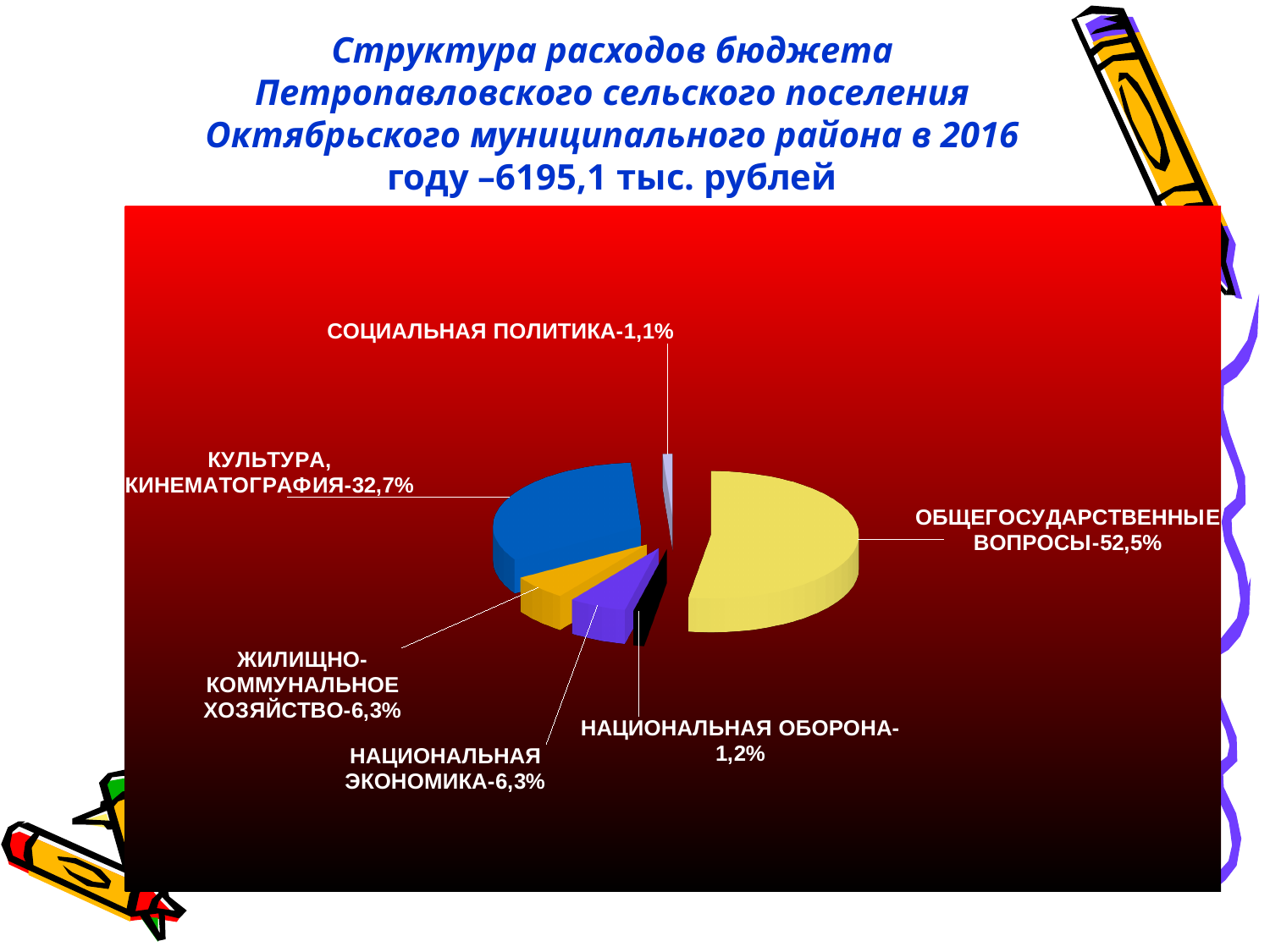
What percentage is shown for НАЦИОНАЛЬНАЯ ОБОРОНА? 1,2% Which category has the largest share of the pie? ОБЩЕГОСУДАРСТВЕННЫЕ ВОПРОСЫ What colour is the slice for ОБЩЕГОСУДАРСТВЕННЫЕ ВОПРОСЫ? yellow How many slices does the pie chart have? 6 What percentage is shown for ЖИЛИЩНО-КОММУНАЛЬНОЕ ХОЗЯЙСТВО? 6,3% What total budget expenditure amount is stated in the slide title? 6195,1 тыс. рублей What percentage is shown for КУЛЬТУРА, КИНЕМАТОГРАФИЯ? 32,7% What kind of chart is shown on the slide? pie chart What share of the budget expenditure goes to ОБЩЕГОСУДАРСТВЕННЫЕ ВОПРОСЫ? 52,5% Which category has the smallest share of the pie? СОЦИАЛЬНАЯ ПОЛИТИКА Which is larger, the share for НАЦИОНАЛЬНАЯ ЭКОНОМИКА or the share for НАЦИОНАЛЬНАЯ ОБОРОНА? НАЦИОНАЛЬНАЯ ЭКОНОМИКА What is the difference in percentage points between ОБЩЕГОСУДАРСТВЕННЫЕ ВОПРОСЫ and КУЛЬТУРА, КИНЕМАТОГРАФИЯ? 19,8